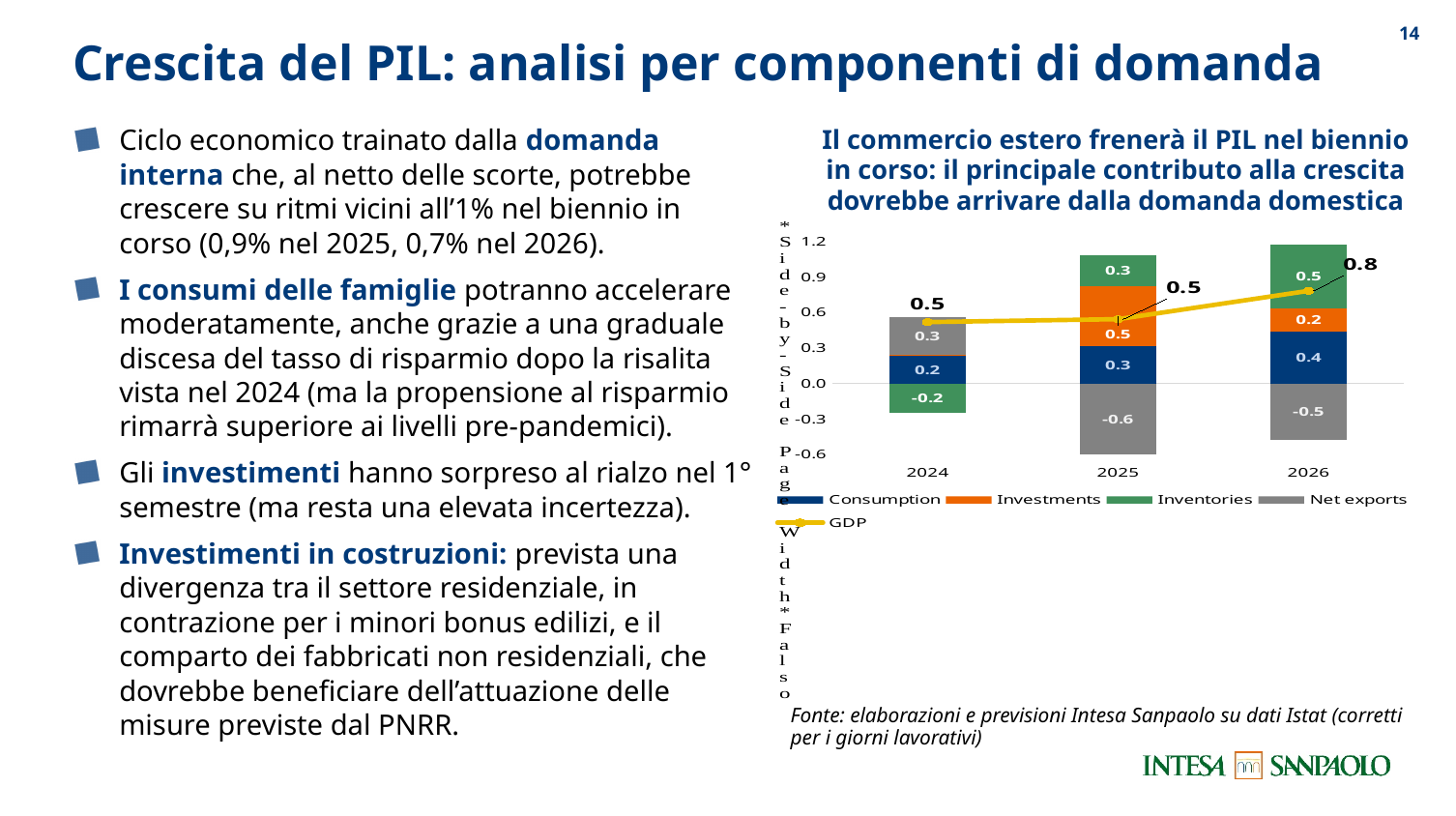
What is the Inventories contribution in 2024? -0.2 How many years are shown on the x axis of the chart? 3 What is the Net exports contribution in 2025? -0.6 What is the difference between the Investments contribution in 2025 and in 2026? 0.3 How many series does the chart legend list? 5 What is the Investments contribution in 2026? 0.2 What is the GDP value shown for 2026? 0.8 In which year is the GDP value highest? 2026 Does the Consumption contribution rise or fall from 2024 to 2026? rise What is the Consumption contribution in 2025? 0.3 Which year has the larger Consumption contribution, 2024 or 2026? 2026 In which year is the Net exports contribution lowest? 2025